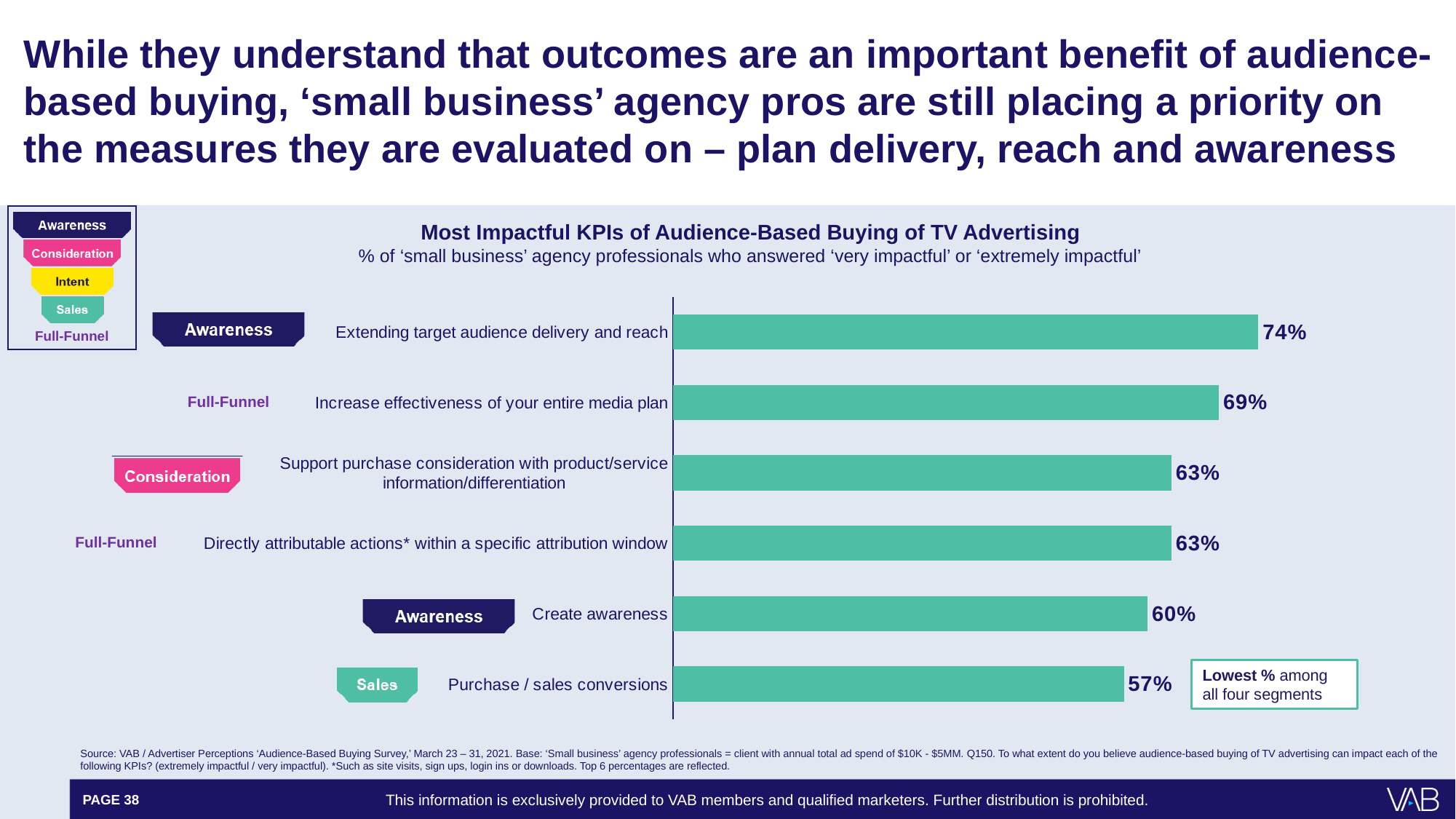
Which KPI has the highest percentage in the chart? Extending target audience delivery and reach What percentage of 'small business' agency professionals rated 'Extending target audience delivery and reach' as very or extremely impactful? 74% What is the value shown for 'Increase effectiveness of your entire media plan'? 69% What is the difference in percentage points between 'Extending target audience delivery and reach' and 'Purchase / sales conversions'? 17 percentage points What is the value shown for 'Create awareness'? 60% Which funnel segment label is attached to 'Support purchase consideration with product/service information/differentiation'? Consideration What is the value shown for 'Purchase / sales conversions'? 57% Which has a higher value: 'Increase effectiveness of your entire media plan' or 'Create awareness'? Increase effectiveness of your entire media plan Which KPI has the lowest percentage in the chart? Purchase / sales conversions What is the title of the chart? Most Impactful KPIs of Audience-Based Buying of TV Advertising What type of chart is shown on the slide? Bar chart How many KPIs are plotted in the chart? 6